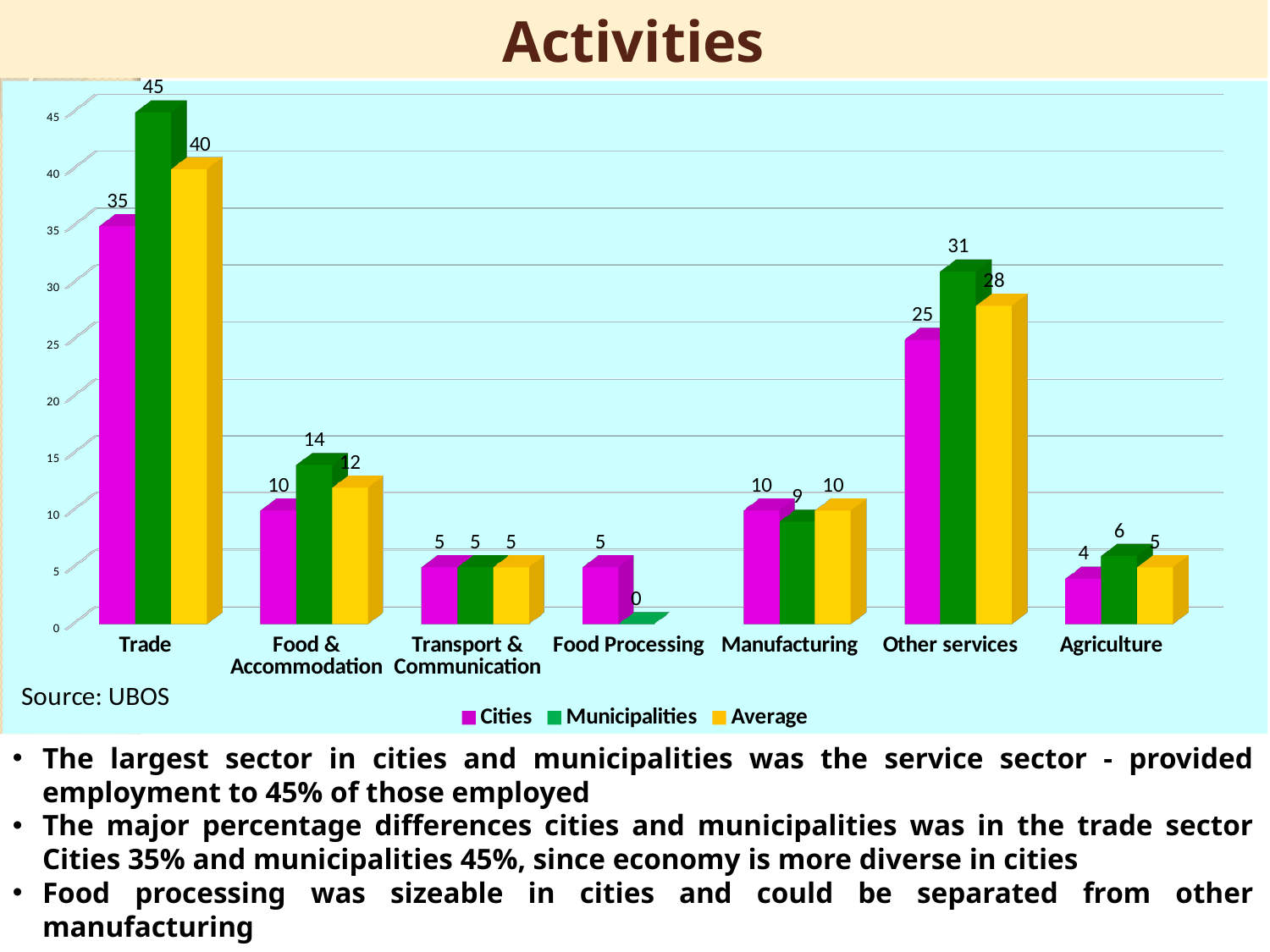
Which category has the lowest Average value? Transport & Communication and Agriculture (both 5) What is the Cities value for Other services? 25 What is the Municipalities value for Trade? 45 What is the Municipalities value for Food Processing? 0 Which is larger for Manufacturing, the Cities value or the Municipalities value? Cities How many categories are shown on the x axis? 7 Which category has the highest Cities value? Trade What kind of chart is shown on the slide? Bar chart What is the difference between the Municipalities and Cities values for Other services? 6 How many series does the legend list? 3 What is the Average value for Food & Accommodation? 12 What is the difference between the Municipalities and Cities values for Trade? 10